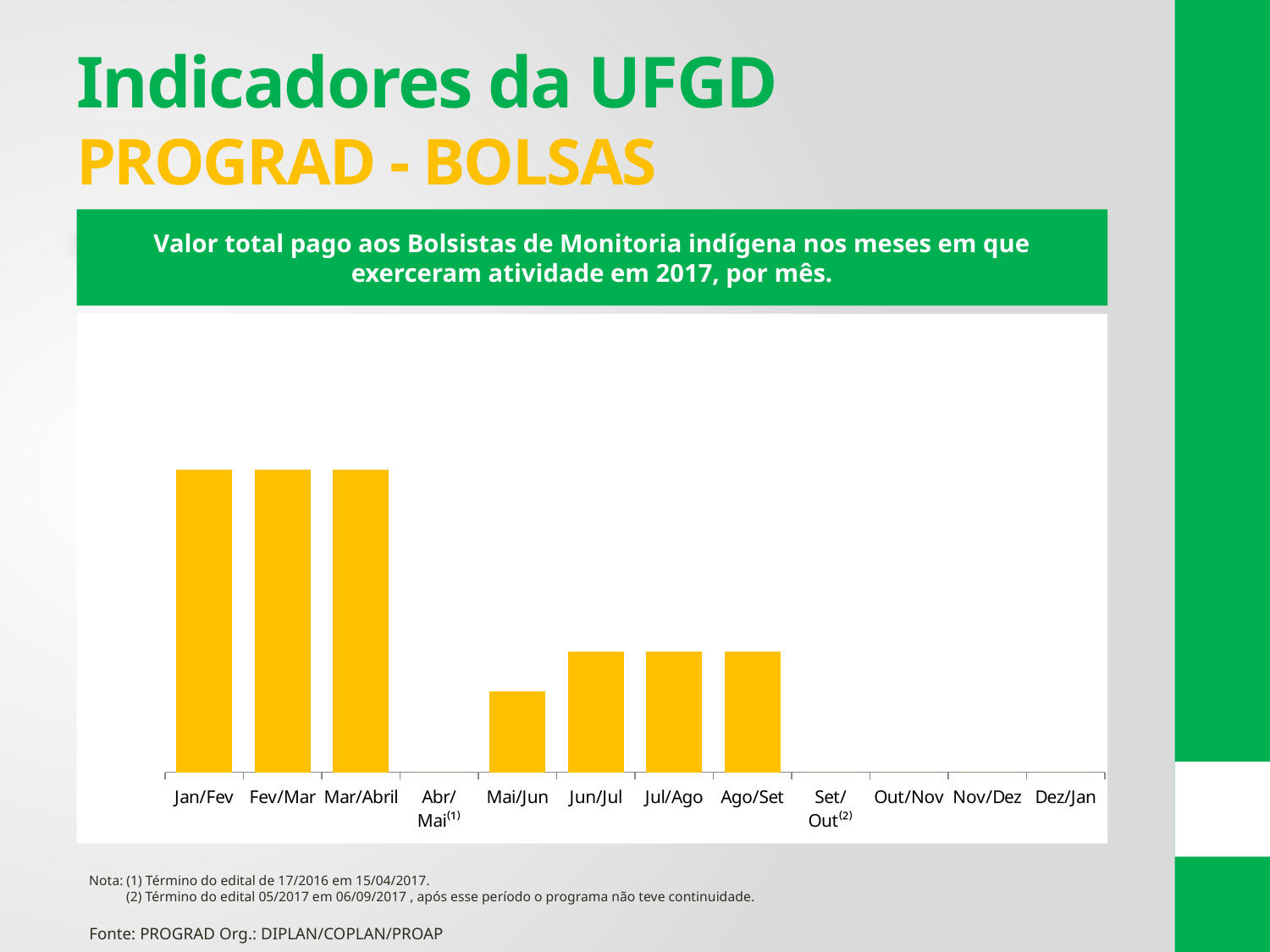
What is the title of the chart? Valor total pago aos Bolsistas de Monitoria indígena nos meses em que exerceram atividade em 2017, por mês. Which is larger, the value for Mar/Abril or the value for Ago/Set? Mar/Abril Which month periods after Ago/Set show no bar in the chart? Set/Out, Out/Nov, Nov/Dez, Dez/Jan Which is larger, the value for Jan/Fev or the value for Mai/Jun? Jan/Fev Which is larger, the value for Jun/Jul or the value for Mai/Jun? Jun/Jul Do the values rise or fall from Mar/Abril to Mai/Jun? fall What colour are the bars in the chart? yellow Do the values rise or fall from Mai/Jun to Jun/Jul? rise How many month-period categories are shown on the x axis of the chart? 12 Which month period has the shortest visible bar in the chart? Mai/Jun How many month periods in the chart have a visible bar (a non-zero value)? 7 What kind of chart is shown on the slide? bar chart